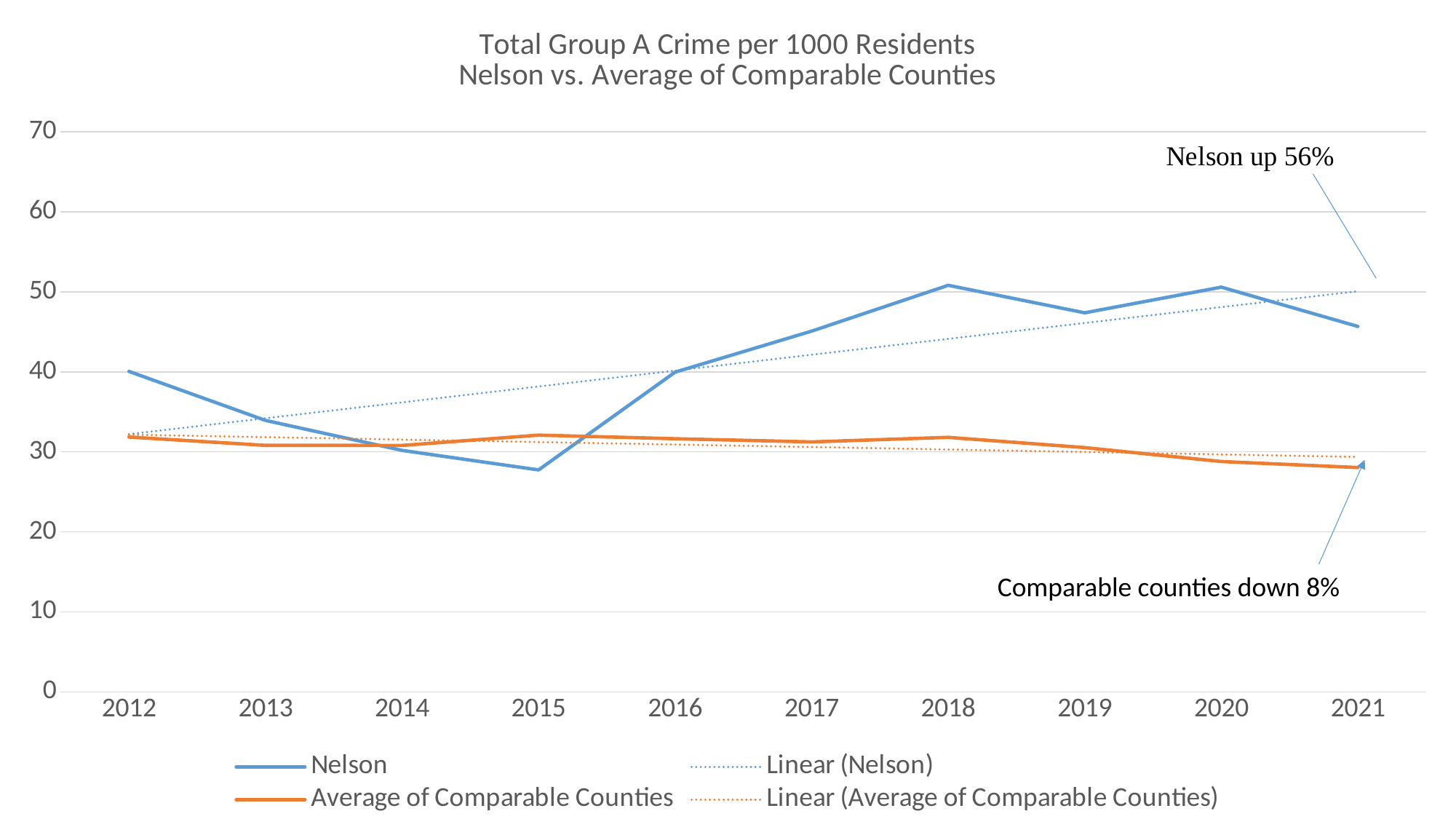
How many entries does the legend list? 4 How many years are plotted along the x axis? 10 Is the Nelson value for 2012 greater or less than 30? greater In which year is the Nelson value lowest? 2015 Is the Nelson value for 2021 greater or less than 40? greater Is the Average of Comparable Counties value for 2018 greater or less than 40? less What kind of chart is shown on the slide? line chart Does the Linear (Nelson) trend line rise or fall from 2012 to 2021? rise In 2015, which is larger: Nelson or Average of Comparable Counties? Average of Comparable Counties According to the annotation on the chart, by what percentage is Nelson up? 56% In 2021, which is larger: Nelson or Average of Comparable Counties? Nelson